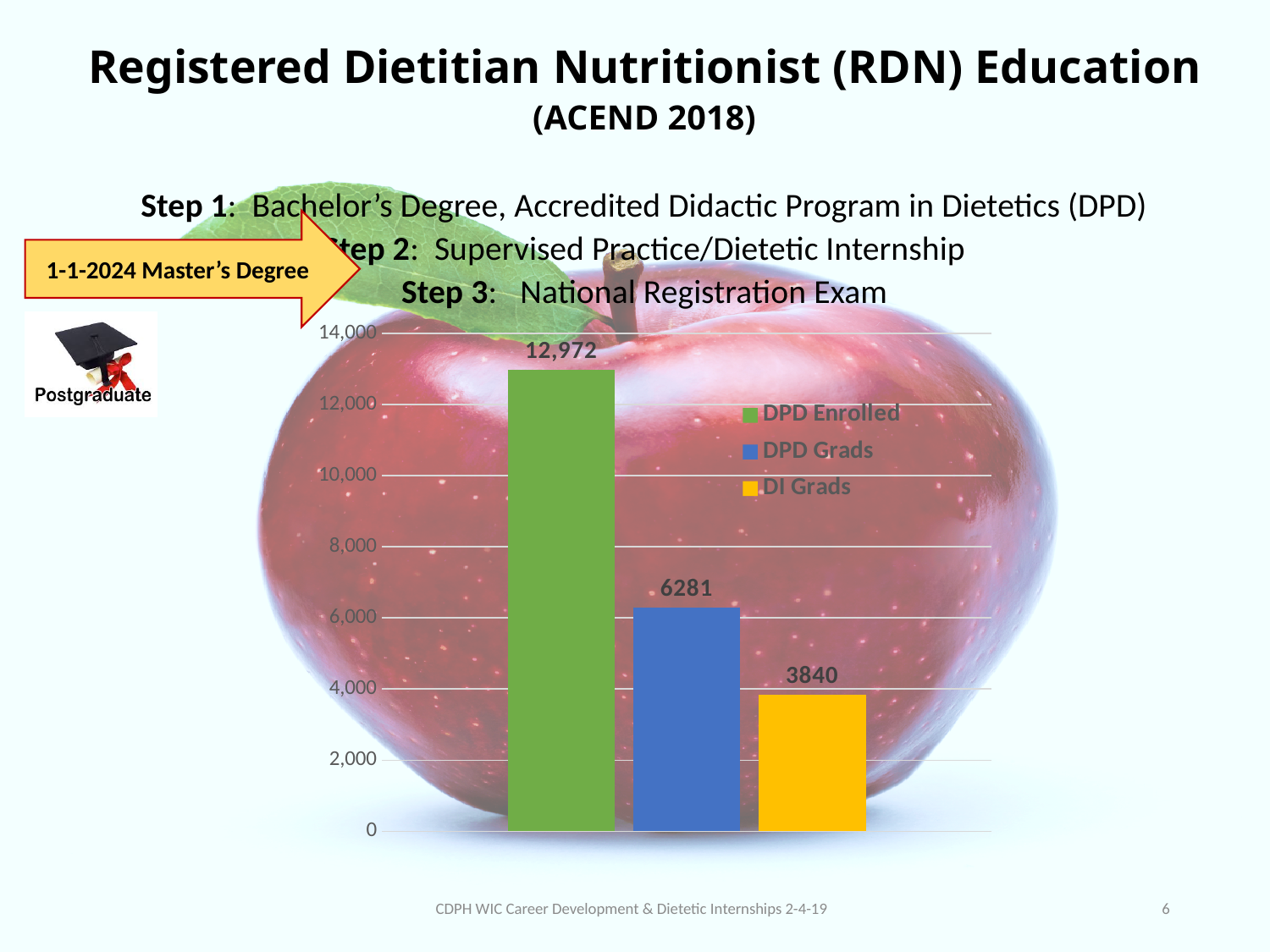
Which is larger, DPD Grads or DI Grads? DPD Grads What kind of chart is shown on the slide? bar chart Which series has the lowest value? DI Grads What is the value for DPD Enrolled? 12,972 How many series does the legend list? 3 What colour is the bar for DI Grads? yellow What is the difference between DPD Grads and DI Grads? 2441 What is the difference between DPD Enrolled and DPD Grads? 6691 What is the value for DPD Grads? 6281 What is the value for DI Grads? 3840 Is the value for DPD Enrolled greater or less than 12,000? greater Which series has the highest value? DPD Enrolled